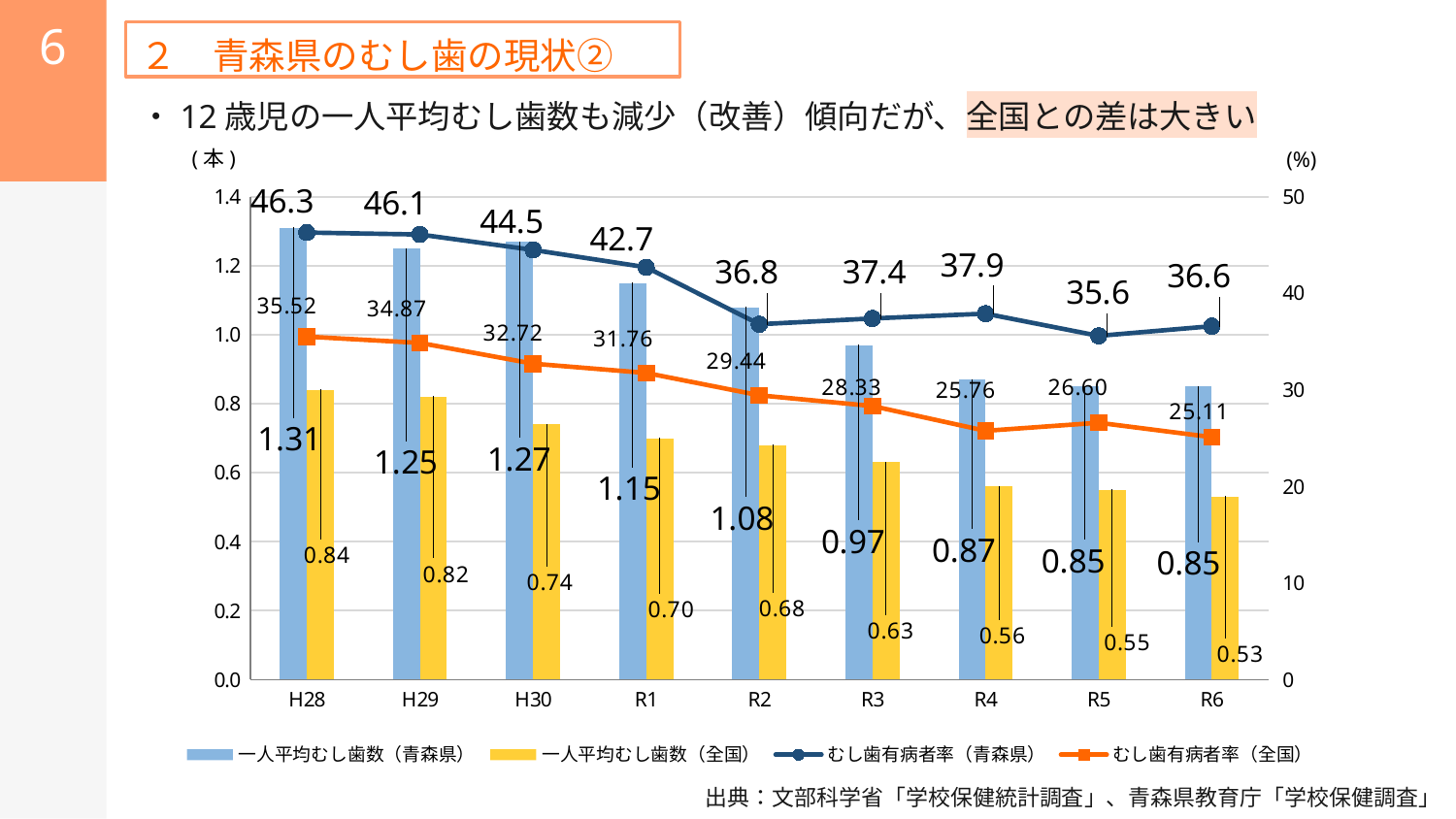
What is the difference between 一人平均むし歯数（青森県） and 一人平均むし歯数（全国） in R1? 0.45 What is the value of むし歯有病者率（全国） for H30? 32.72 What unit is shown on the left vertical axis? 本 What is the value of むし歯有病者率（青森県） for R2? 36.8 In which year is 一人平均むし歯数（全国） the highest? H28 In which year is むし歯有病者率（青森県） the lowest? R5 What is the overall trend of 一人平均むし歯数（青森県） from H28 to R6? Falling Which is larger in R4: むし歯有病者率（青森県） or むし歯有病者率（全国）? むし歯有病者率（青森県） What is the value of 一人平均むし歯数（全国） for R6? 0.53 What is the value of 一人平均むし歯数（青森県） for H28? 1.31 How many series does the legend list? 4 How many years are shown on the x axis? 9